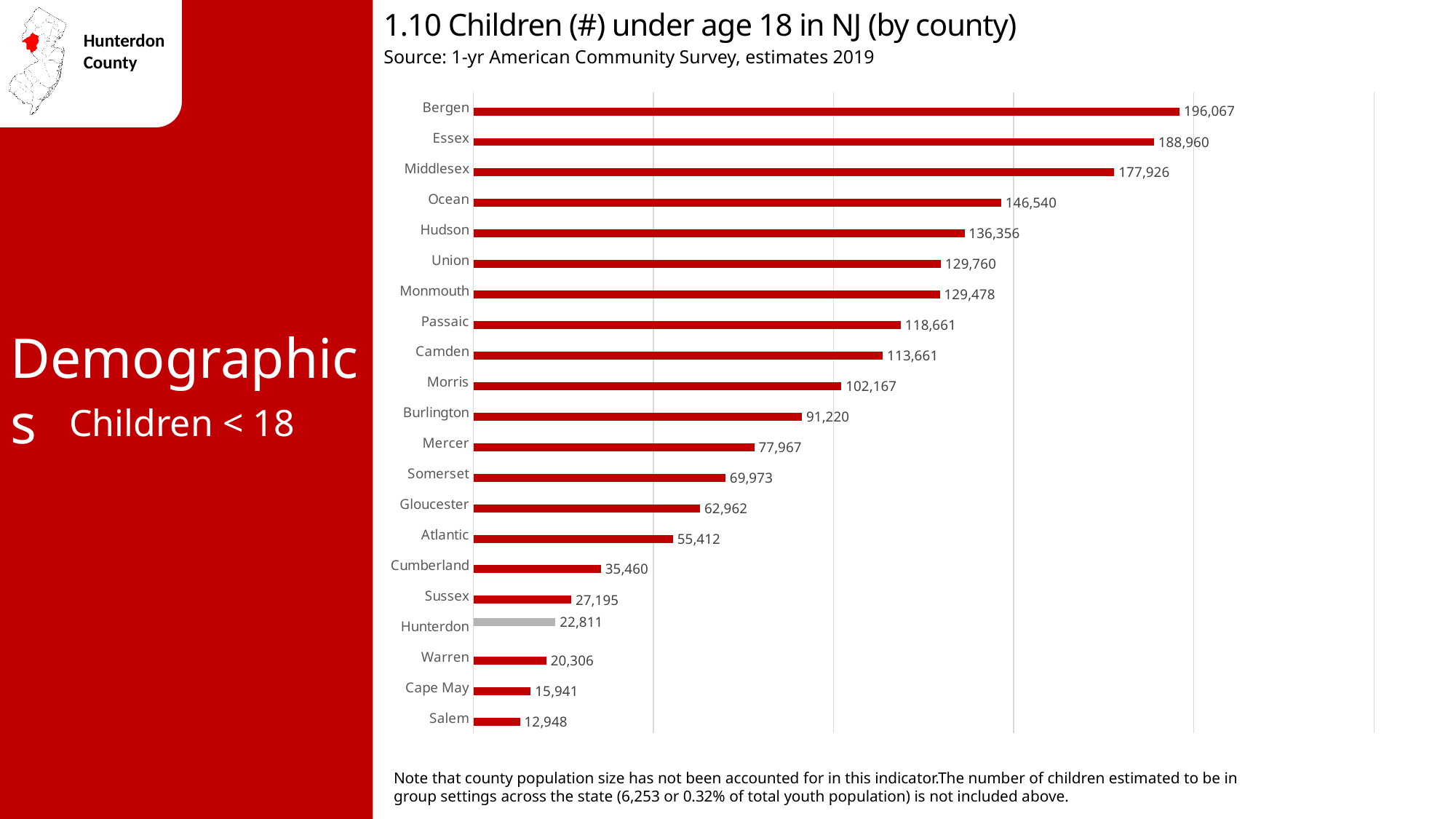
What is the source cited for the chart data? 1-yr American Community Survey, estimates 2019 What kind of chart is shown on the slide? Bar chart What is the number of children under age 18 in Bergen County? 196,067 What is the difference between the values for Hunterdon and Warren? 2,505 What is the difference between the values for Bergen and Essex? 7,107 How many children under 18 are shown for Salem County? 12,948 How many counties are shown in the chart? 21 Which county has a larger value, Ocean or Hudson? Ocean What is the value shown for Hunterdon County? 22,811 Which county has the highest number of children under age 18? Bergen Which county's bar is shown in grey rather than red? Hunterdon Which county has the lowest number of children under age 18? Salem